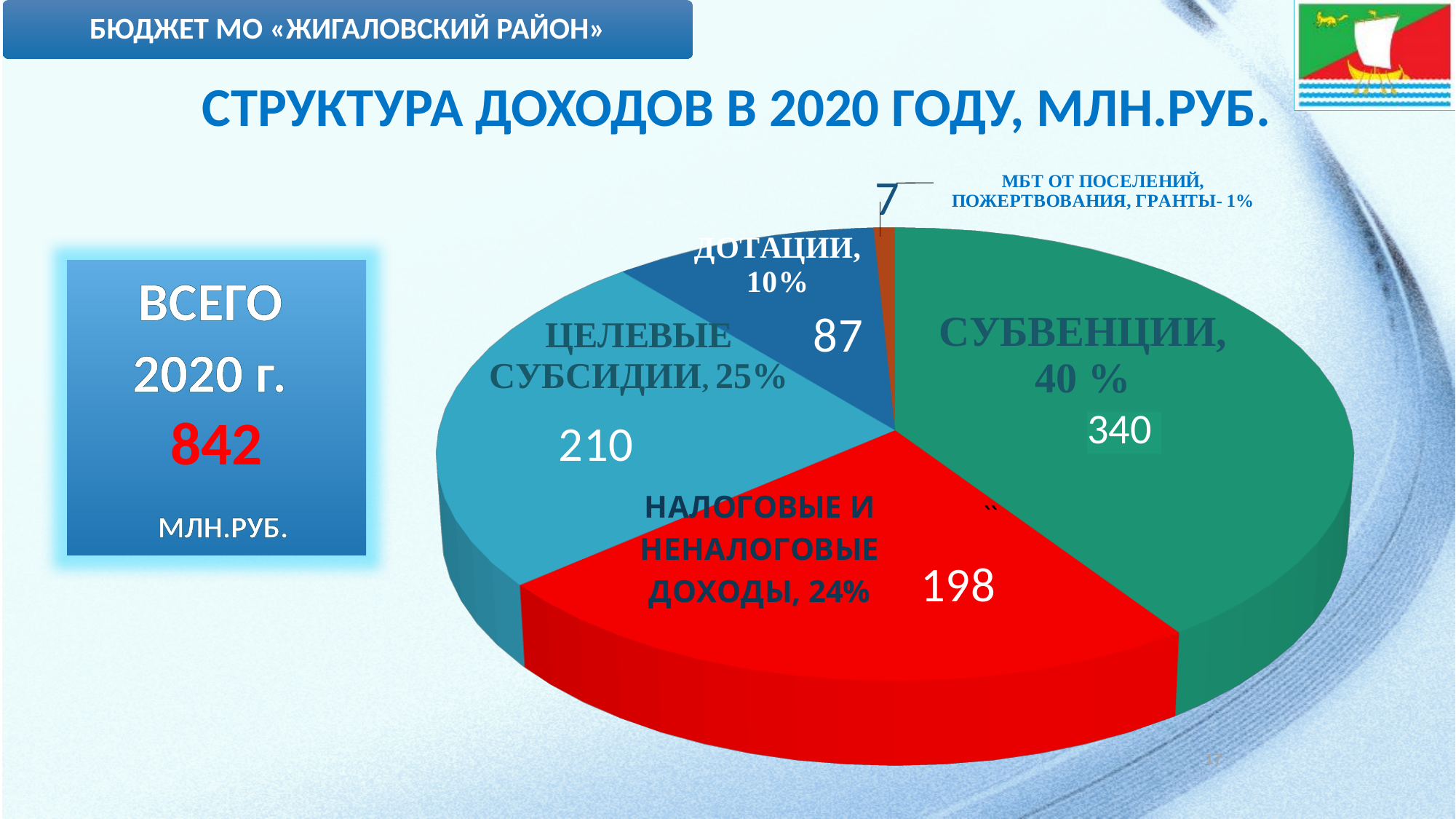
What is the value for «ДОТАЦИИ» in the pie chart? 87 How many slices does the pie chart have? 5 What is the value for «НАЛОГОВЫЕ И НЕНАЛОГОВЫЕ ДОХОДЫ» in the pie chart? 198 Which category has the smallest slice in the pie chart? МБТ ОТ ПОСЕЛЕНИЙ, ПОЖЕРТВОВАНИЯ, ГРАНТЫ What is the value for «ЦЕЛЕВЫЕ СУБСИДИИ» in the pie chart? 210 What is the difference between the values for «СУБВЕНЦИИ» and «ЦЕЛЕВЫЕ СУБСИДИИ»? 130 What type of chart is shown on the slide? pie chart What share of the pie does «СУБВЕНЦИИ» represent? 40 % What is the value for «СУБВЕНЦИИ» in the pie chart? 340 What share of the pie does «ДОТАЦИИ» represent? 10% What is the value for «МБТ ОТ ПОСЕЛЕНИЙ, ПОЖЕРТВОВАНИЯ, ГРАНТЫ» in the pie chart? 7 Which category has the largest slice in the pie chart? СУБВЕНЦИИ